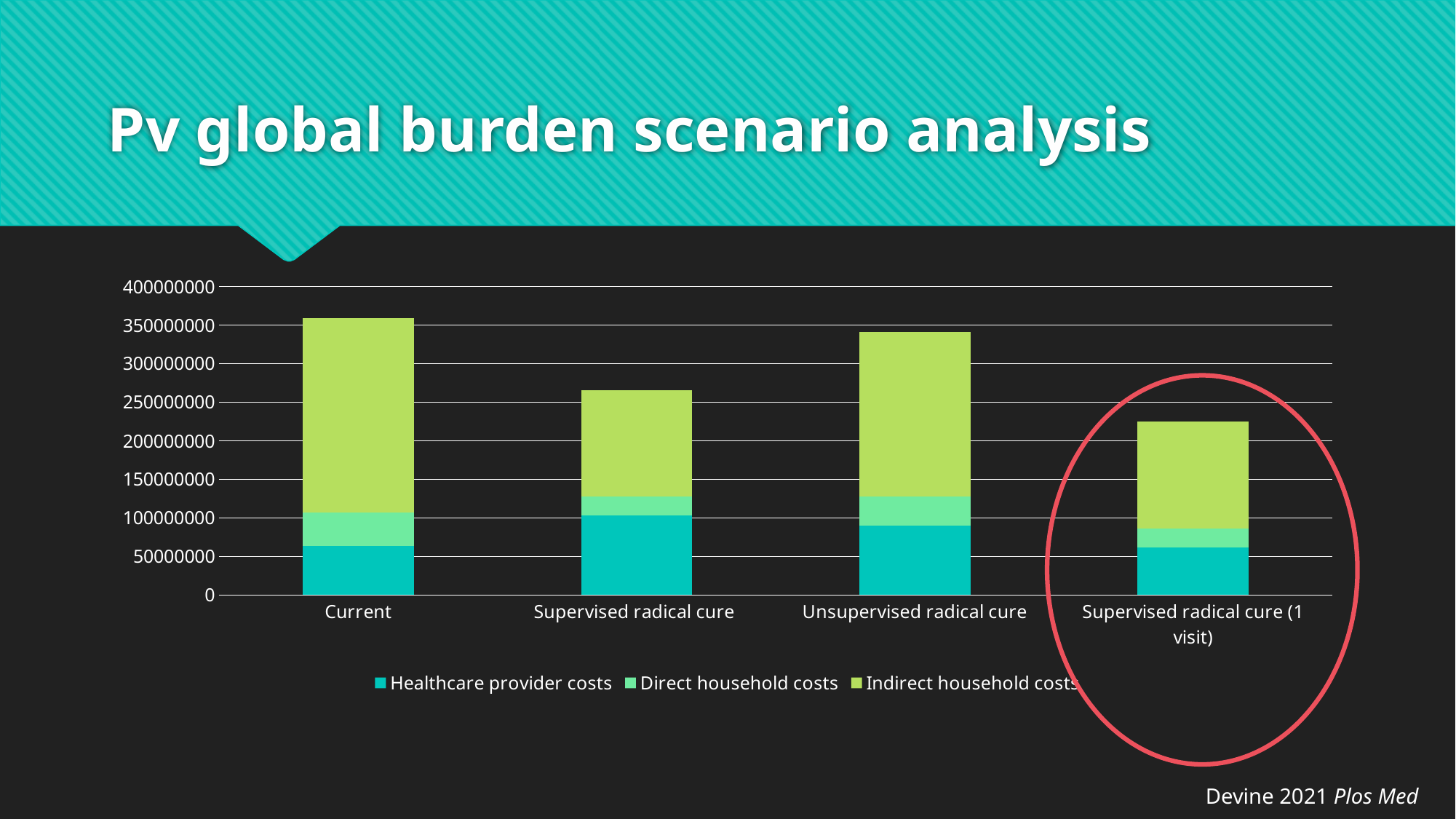
Is the Healthcare provider costs segment for Current greater or less than 100000000? less What kind of chart is shown on the slide? Stacked bar chart Which scenario's bar is highlighted with a red circle on the slide? Supervised radical cure (1 visit) Which scenario has the lowest total cost bar? Supervised radical cure (1 visit) Is the total bar for Unsupervised radical cure greater or less than 300000000? greater Which has the larger total bar, Supervised radical cure or Unsupervised radical cure? Unsupervised radical cure Which scenario has the highest total cost bar? Current How many series does the chart's legend list? 3 How many scenario categories are shown on the x axis of the chart? 4 Which has the larger Healthcare provider costs segment, Current or Supervised radical cure? Supervised radical cure Is the total bar for Supervised radical cure (1 visit) greater or less than 250000000? less